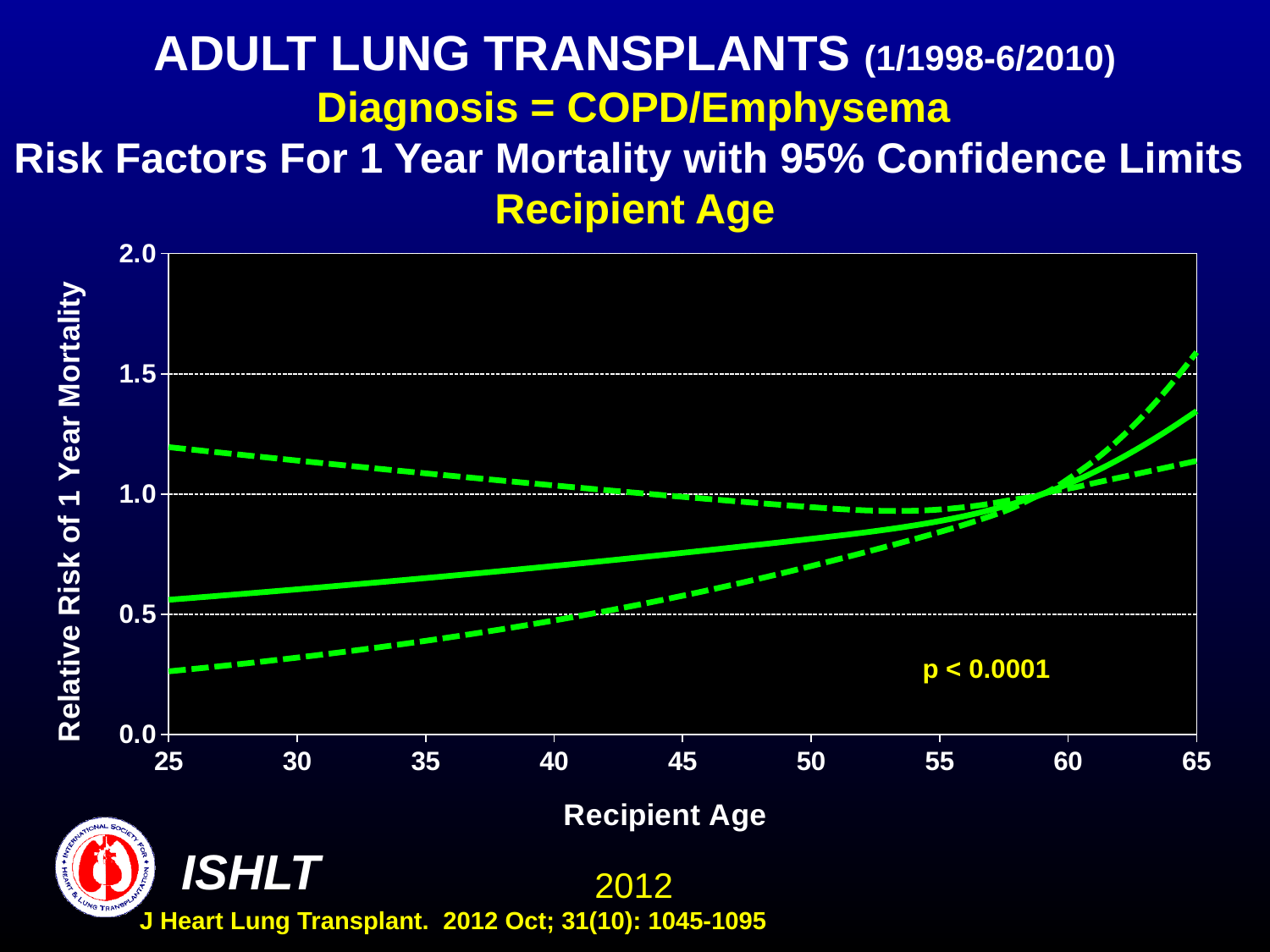
How many lines are plotted on the chart? 3 What kind of chart is shown on the slide? line chart Is the solid relative risk line higher at recipient age 65 or at recipient age 25? 65 Does the solid line for relative risk of 1 year mortality rise or fall as recipient age increases from 25 to 65? rise Is the value of the solid relative risk line at recipient age 40 greater or less than 1.0? less Is the lower dashed confidence limit at recipient age 25 greater or less than 0.5? less Is the upper dashed confidence limit at recipient age 25 greater or less than 1.0? greater How many tick labels are shown on the Recipient Age axis? 9 What is the label of the vertical axis? Relative Risk of 1 Year Mortality What p-value is printed on the chart? p < 0.0001